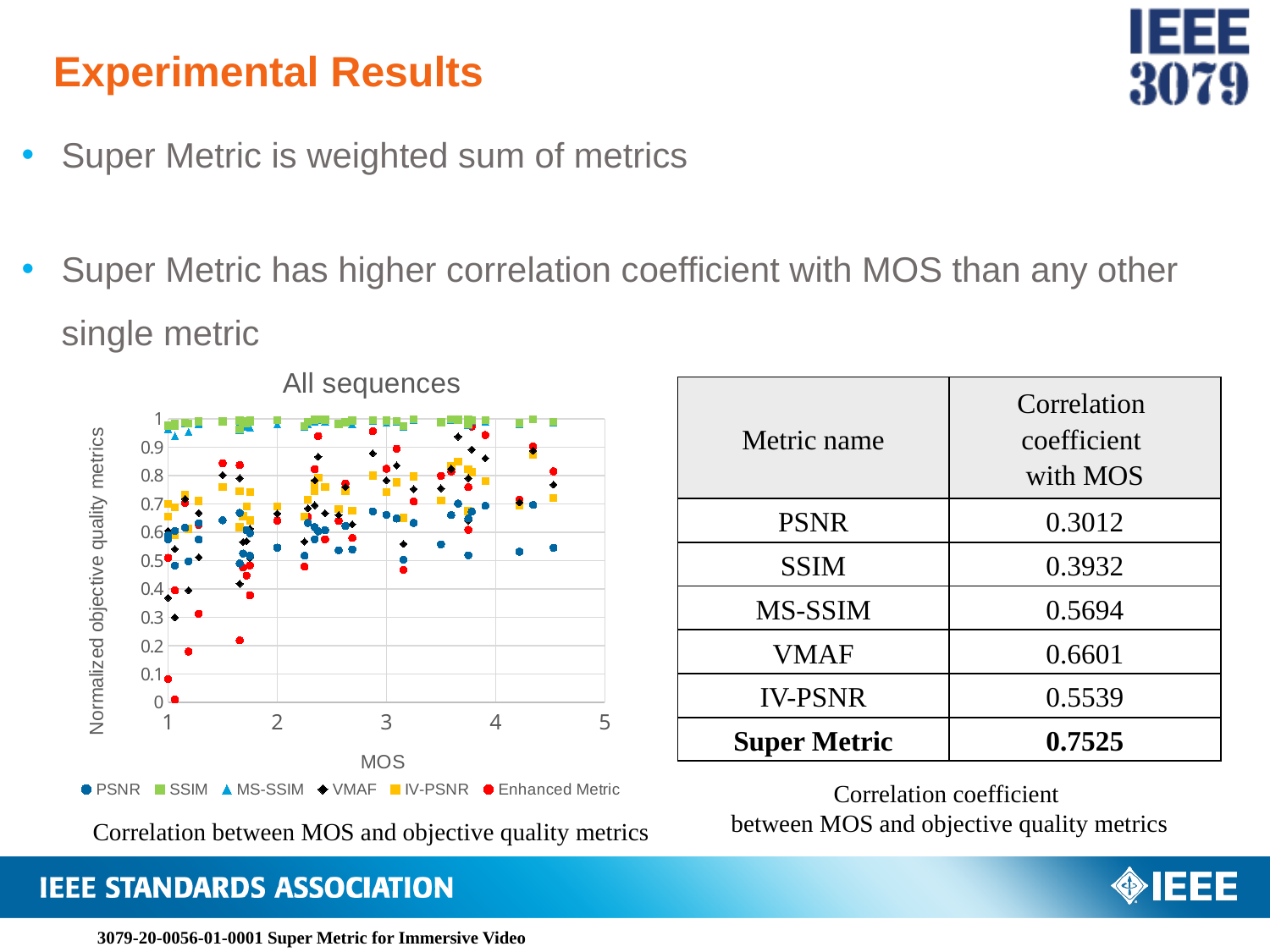
In the "All sequences" chart, which series has higher values: SSIM or PSNR? SSIM How many series does the legend of the "All sequences" chart list? 6 In the "All sequences" chart, which series has the highest plotted values overall? SSIM What is the title of the chart on the slide? All sequences What is the label of the x axis of the "All sequences" chart? MOS In the "All sequences" chart, do the Enhanced Metric values generally rise or fall as MOS increases? rise What kind of chart is the "All sequences" chart? scatter chart In the "All sequences" chart, which series contains the lowest plotted point? Enhanced Metric In the "All sequences" chart, are the SSIM values greater or less than 0.9? greater